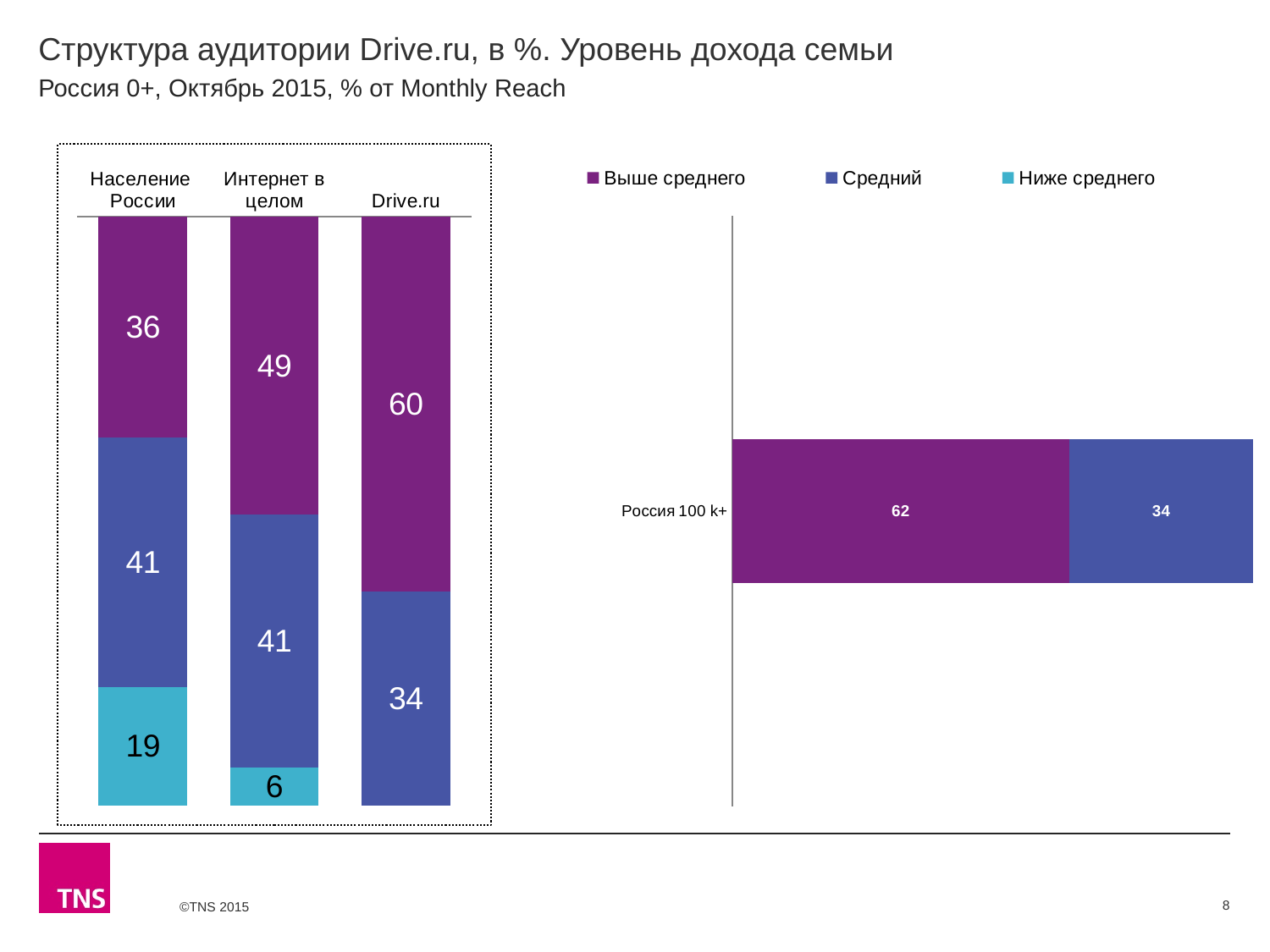
In the left chart, which category has the highest 'Выше среднего' value? Drive.ru In the left chart, is the 'Средний' value larger for Население России or for Drive.ru? Население России In the right chart, what is the 'Выше среднего' value for Россия 100 k+? 62 What type of chart is the chart on the right? Stacked bar chart In the left chart, how many categories are shown on the x axis? 3 In the left chart, what is the value of the 'Средний' segment for Интернет в целом? 41 In the left chart, what is the value of the 'Выше среднего' segment for Drive.ru? 60 In the right chart, what is the total of the labelled segments for Россия 100 k+? 96 In the left chart, what is the difference between the 'Выше среднего' values for Drive.ru and Население России? 24 In the left chart, what is the value of the 'Ниже среднего' segment for Население России? 19 How many series does the legend list? 3 In the left chart, which category has the lowest 'Ниже среднего' value among those labelled? Интернет в целом